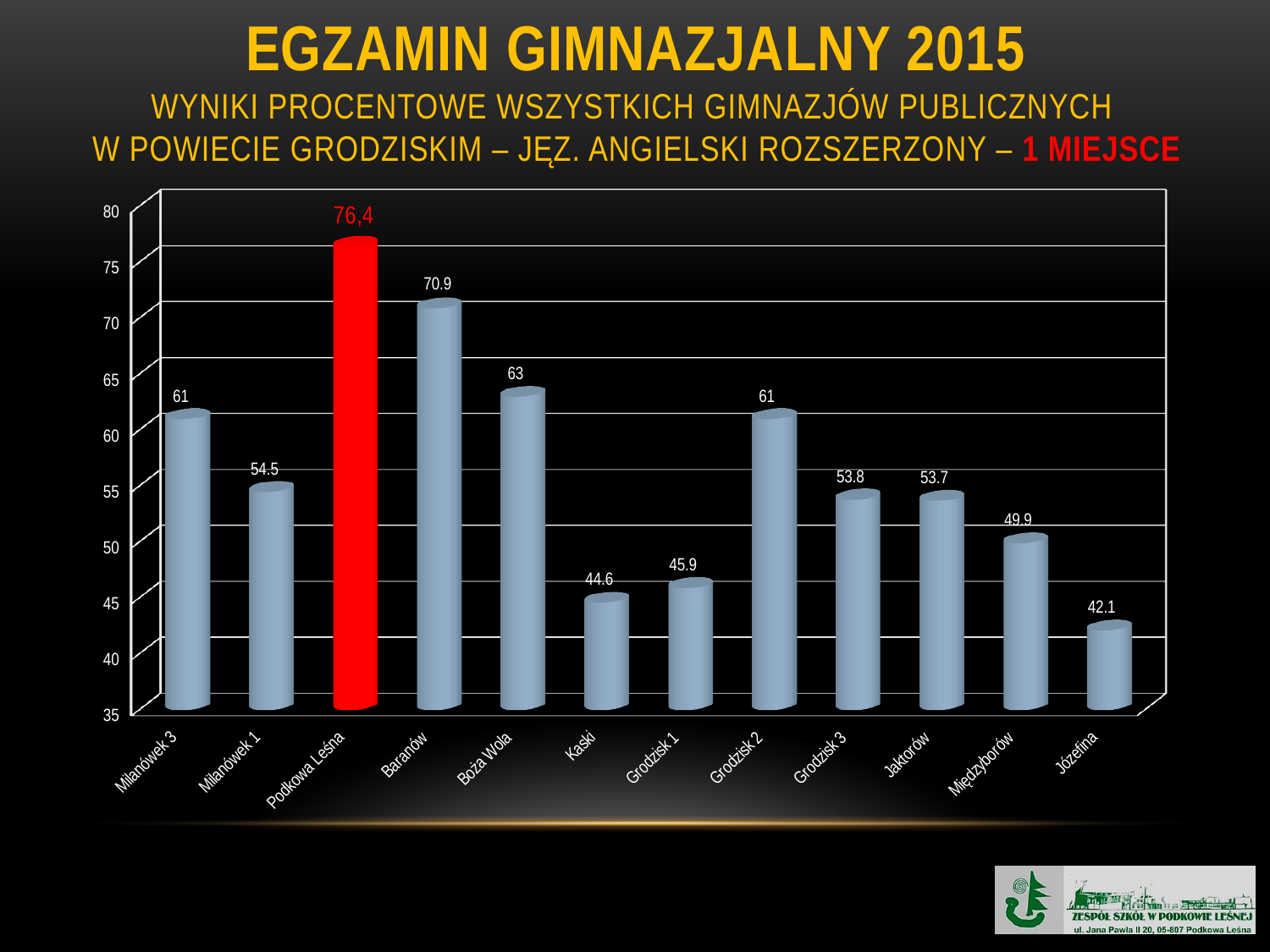
Which bar is coloured red instead of blue? Podkowa Leśna What kind of chart is shown on the slide? bar chart Which is larger, the value for Grodzisk 1 or the value for Grodzisk 2? Grodzisk 2 What is the value for Międzyborów? 49.9 Which category has the highest value? Podkowa Leśna What is the difference between the values for Baranów and Boża Wola? 7.9 What is the value for Kaski? 44.6 What is the value for Podkowa Leśna? 76,4 What is the difference between the values for Milanówek 1 and Józefina? 12.4 How many categories are shown on the x axis? 12 What is the value for Baranów? 70.9 Which category has the lowest value? Józefina